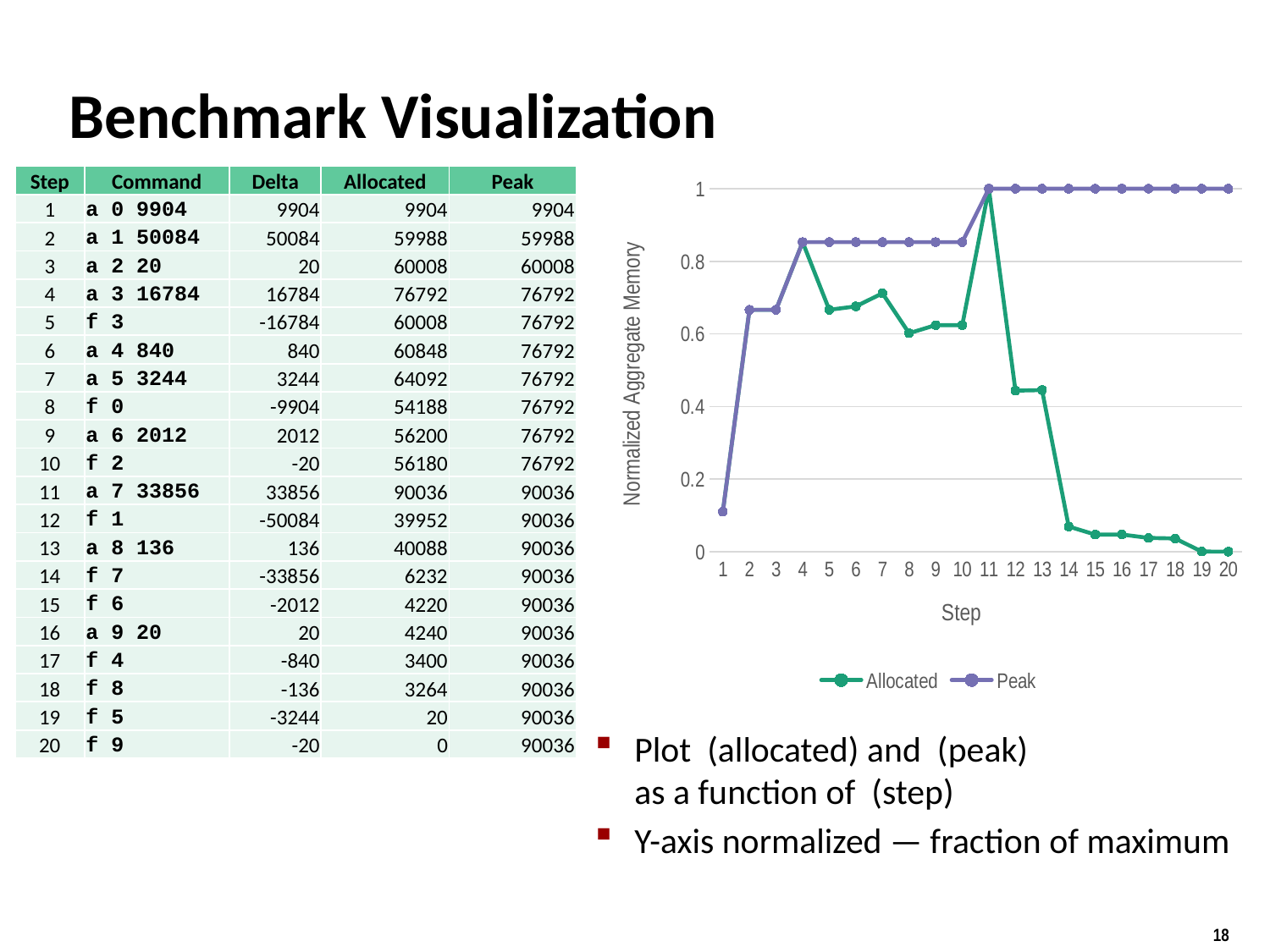
At which step is the Allocated series at its lowest value? 19 and 20 What kind of chart is shown on the slide? line chart What is the Allocated value at step 20? 0 How many series does the chart's legend list? 2 At step 5, which series has the larger value, Allocated or Peak? Peak Does the Allocated series rise or fall from step 11 to step 20? fall Is the Allocated value at step 14 greater or less than 0.2? less Is the Allocated value at step 12 greater or less than 0.4? greater What is the Peak value at step 15? 1 Is the Peak value at step 4 greater or less than 0.8? greater How many steps are plotted along the x axis of the chart? 20 At which step does the Allocated series reach its highest value? 11